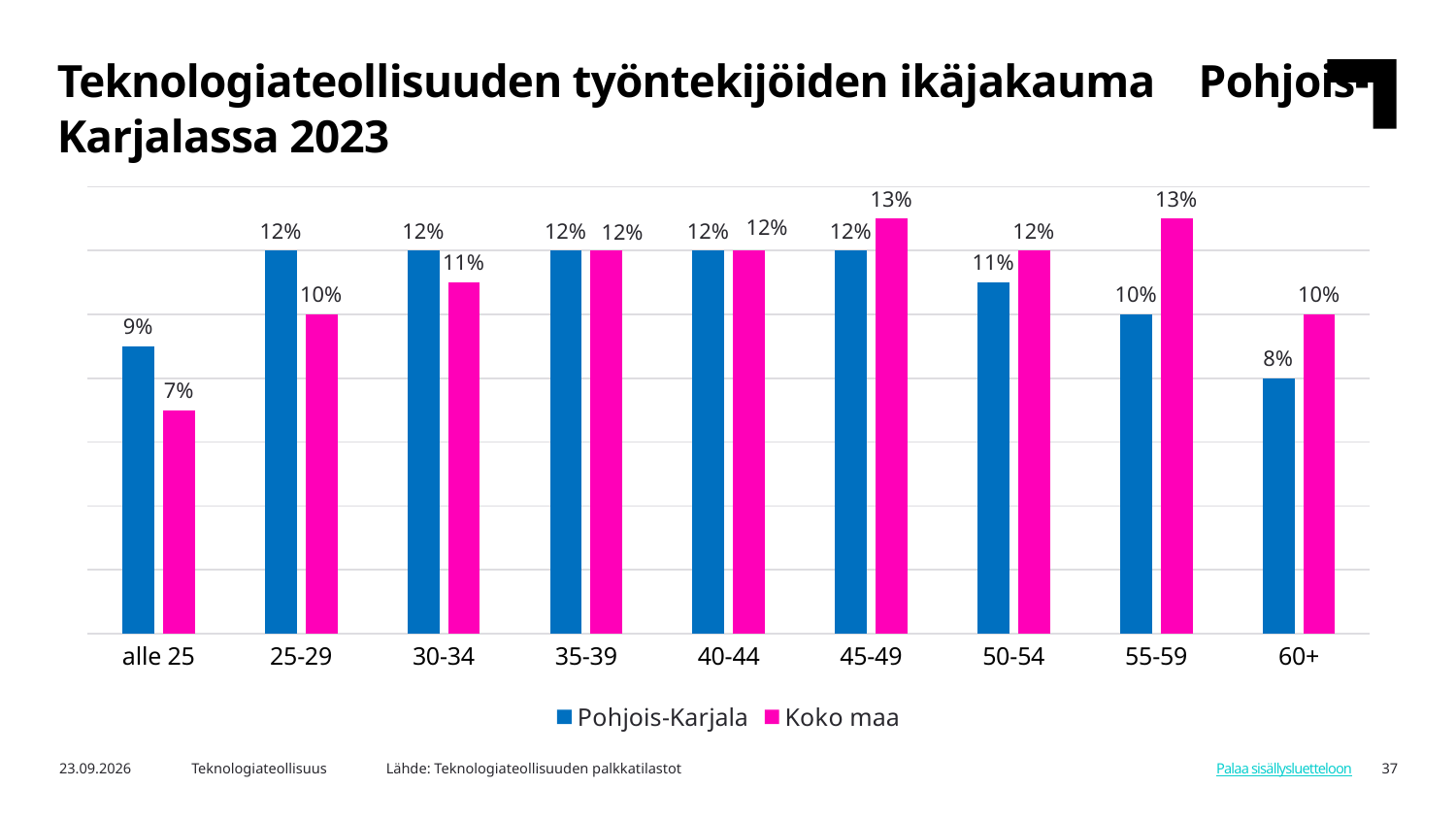
What is the value for Koko maa in the 30-34 age group? 11% What is the value for Koko maa in the 55-59 age group? 13% What is the value for Pohjois-Karjala in the 60+ age group? 8% What is the difference between the Pohjois-Karjala and Koko maa values in the alle 25 age group? 2% In the 25-29 age group, which series has the larger value, Pohjois-Karjala or Koko maa? Pohjois-Karjala How many age groups are shown on the x axis? 9 Which age group has the lowest value for Koko maa? alle 25 Which age group has the lowest value for Pohjois-Karjala? 60+ What is the value for Pohjois-Karjala in the alle 25 age group? 9% How many series does the legend list? 2 What kind of chart is shown on the slide? Bar chart What is the difference between the Pohjois-Karjala and Koko maa values in the 55-59 age group? 3%